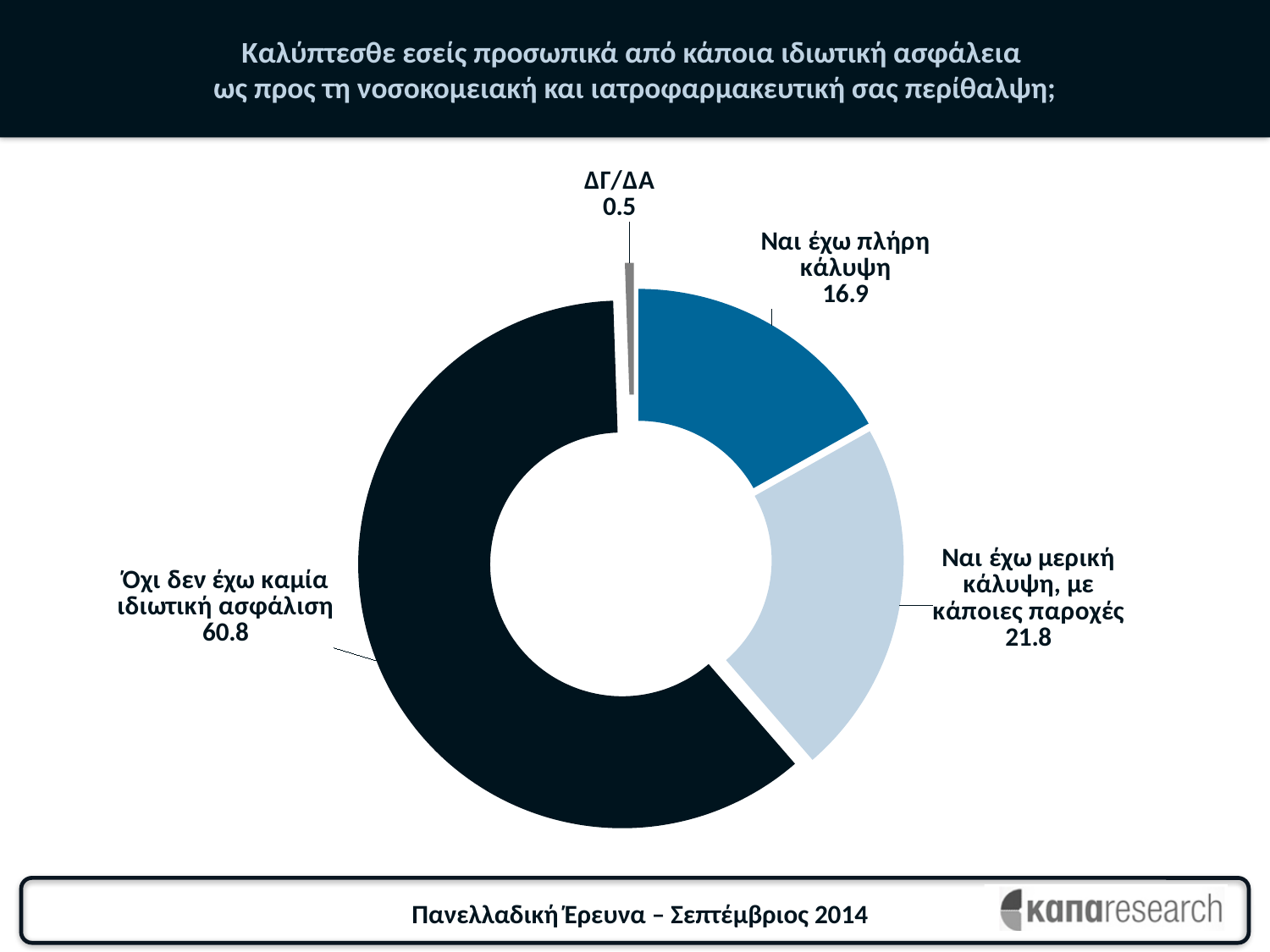
How many categories are shown in the chart? 4 What value is shown for the slice labelled 'Ναι έχω μερική κάλυψη, με κάποιες παροχές'? 21.8 What colour is the slice for 'Ναι έχω πλήρη κάλυψη'? Blue Which category has the largest slice? Όχι δεν έχω καμία ιδιωτική ασφάλιση What is the difference between the values for 'Ναι έχω μερική κάλυψη, με κάποιες παροχές' and 'Ναι έχω πλήρη κάλυψη'? 4.9 What is the difference between the values for 'Όχι δεν έχω καμία ιδιωτική ασφάλιση' and 'Ναι έχω πλήρη κάλυψη'? 43.9 Which category has the smallest slice? ΔΓ/ΔΑ What value is shown for the slice labelled 'Όχι δεν έχω καμία ιδιωτική ασφάλιση'? 60.8 What kind of chart is shown on the slide? Doughnut (pie) chart What value is shown for the slice labelled 'Ναι έχω πλήρη κάλυψη'? 16.9 Which is larger: the value for 'Ναι έχω πλήρη κάλυψη' or the value for 'Ναι έχω μερική κάλυψη, με κάποιες παροχές'? Ναι έχω μερική κάλυψη, με κάποιες παροχές What value is shown for the slice labelled 'ΔΓ/ΔΑ'? 0.5